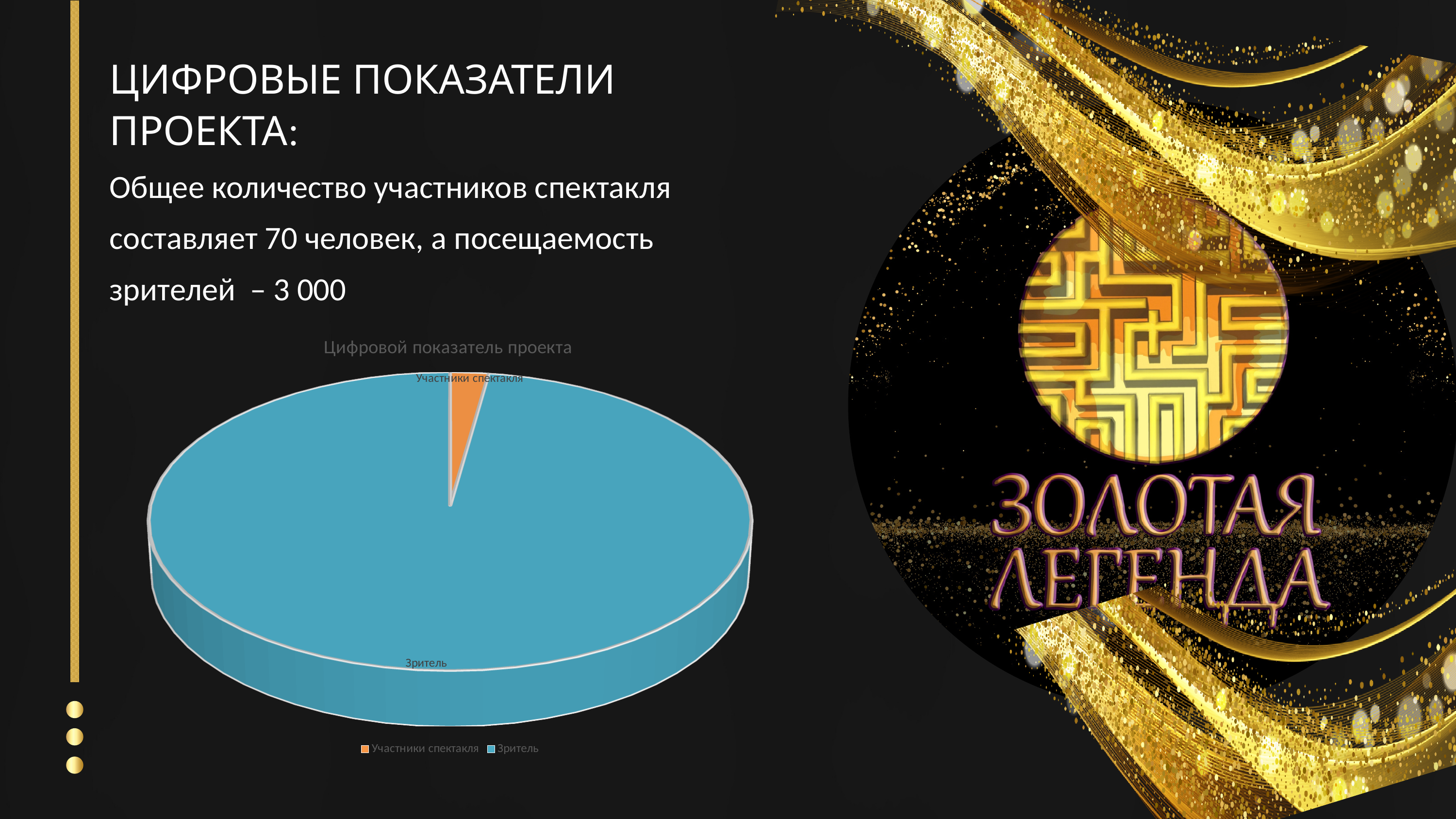
Which category has the smallest slice in the pie chart? Участники спектакля What is the title of the chart? Цифровой показатель проекта How many entries does the chart legend list? 2 Which category has the largest slice in the pie chart? Зритель Which slice is larger: Участники спектакля or Зритель? Зритель What colour is the slice for Участники спектакля? orange How many slices does the pie chart have? 2 What kind of chart is shown on the slide? pie chart